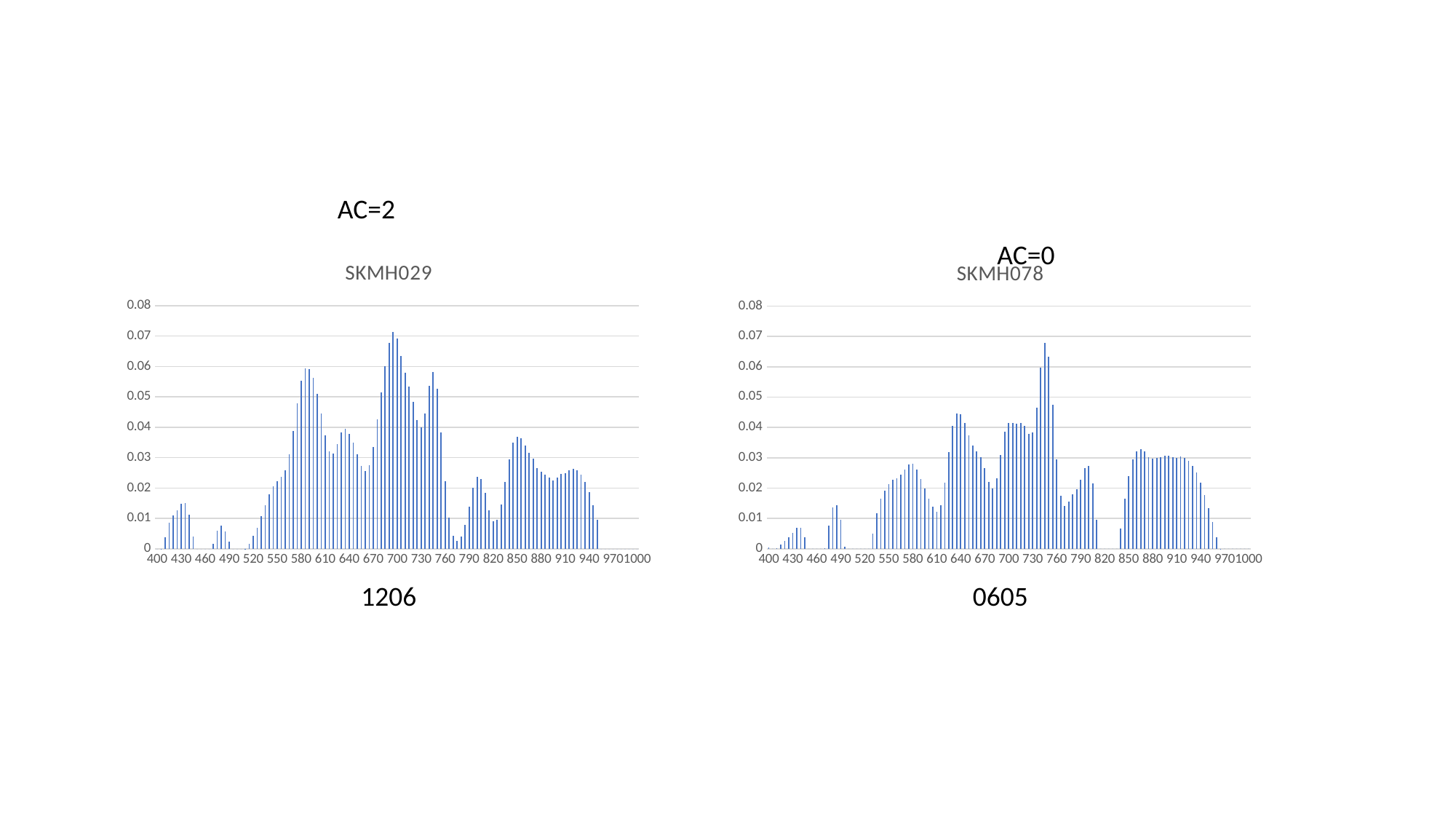
In the SKMH029 chart, is the value at 400 greater or less than 0.01? less In the SKMH029 chart, which is larger, the value at 700 or the value at 850? 700 What is the title of the chart on the right? SKMH078 What is the highest value labelled on the y axis of the SKMH029 chart? 0.08 In the SKMH029 chart, is the value at 580 greater or less than 0.05? greater What kind of chart is the SKMH029 chart on the left? bar chart In the SKMH029 chart, is the value at 850 greater or less than 0.03? greater In the SKMH078 chart, which is larger, the value at 640 or the value at 550? 640